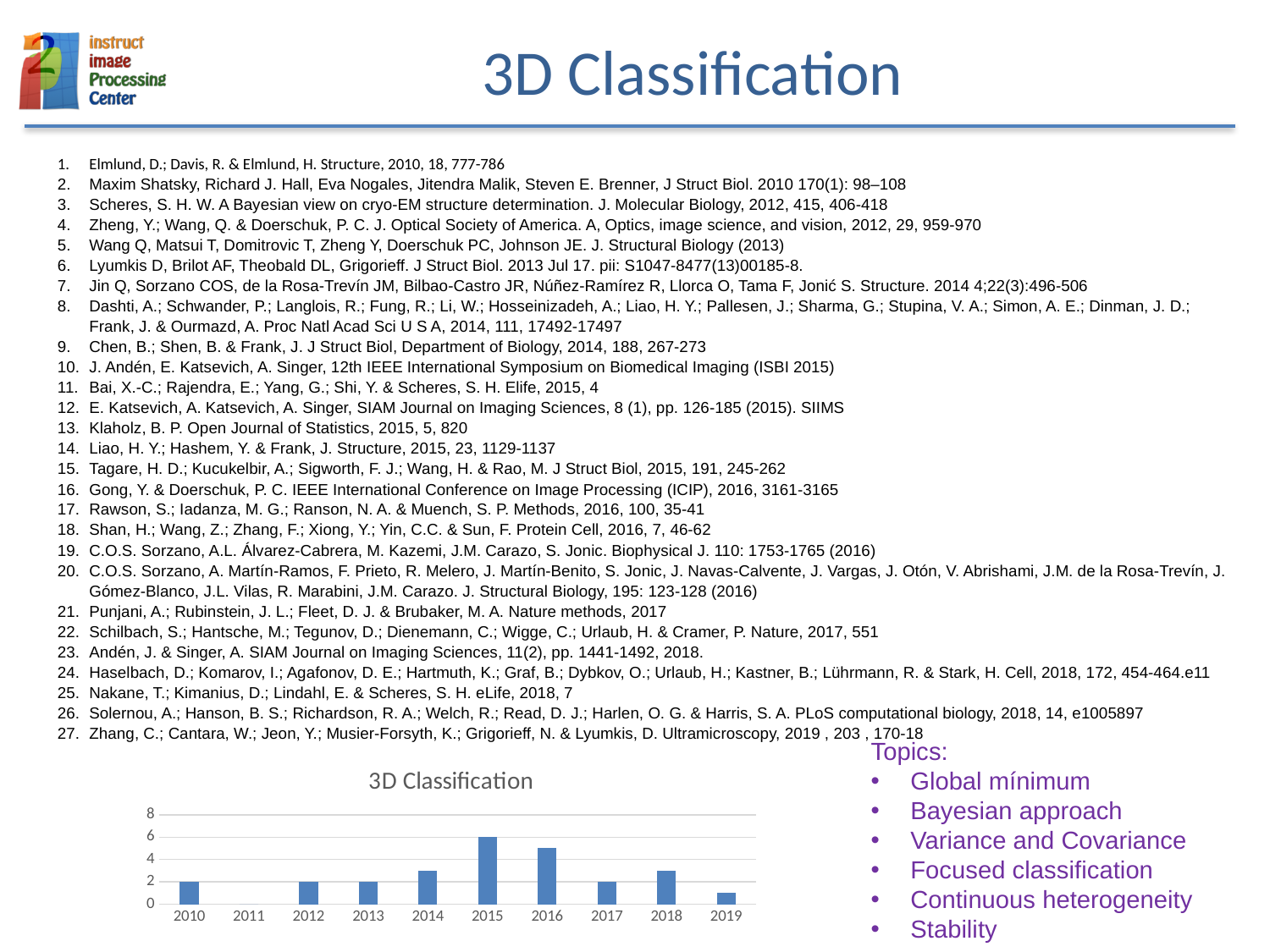
How many years are shown on the x axis of the chart? 10 Do the values rise or fall from 2013 to 2015? rise What kind of chart is shown on the slide? bar chart Which is larger, the value for 2015 or the value for 2016? 2015 What is the value for 2010? 2 What is the title of the chart? 3D Classification Is the value for 2016 greater or less than 4? greater Is the value for 2019 greater or less than 2? less Which year has the highest value in the chart? 2015 Which year has the lowest value in the chart? 2011 What is the value for 2015? 6 What is the difference between the values for 2015 and 2010? 4